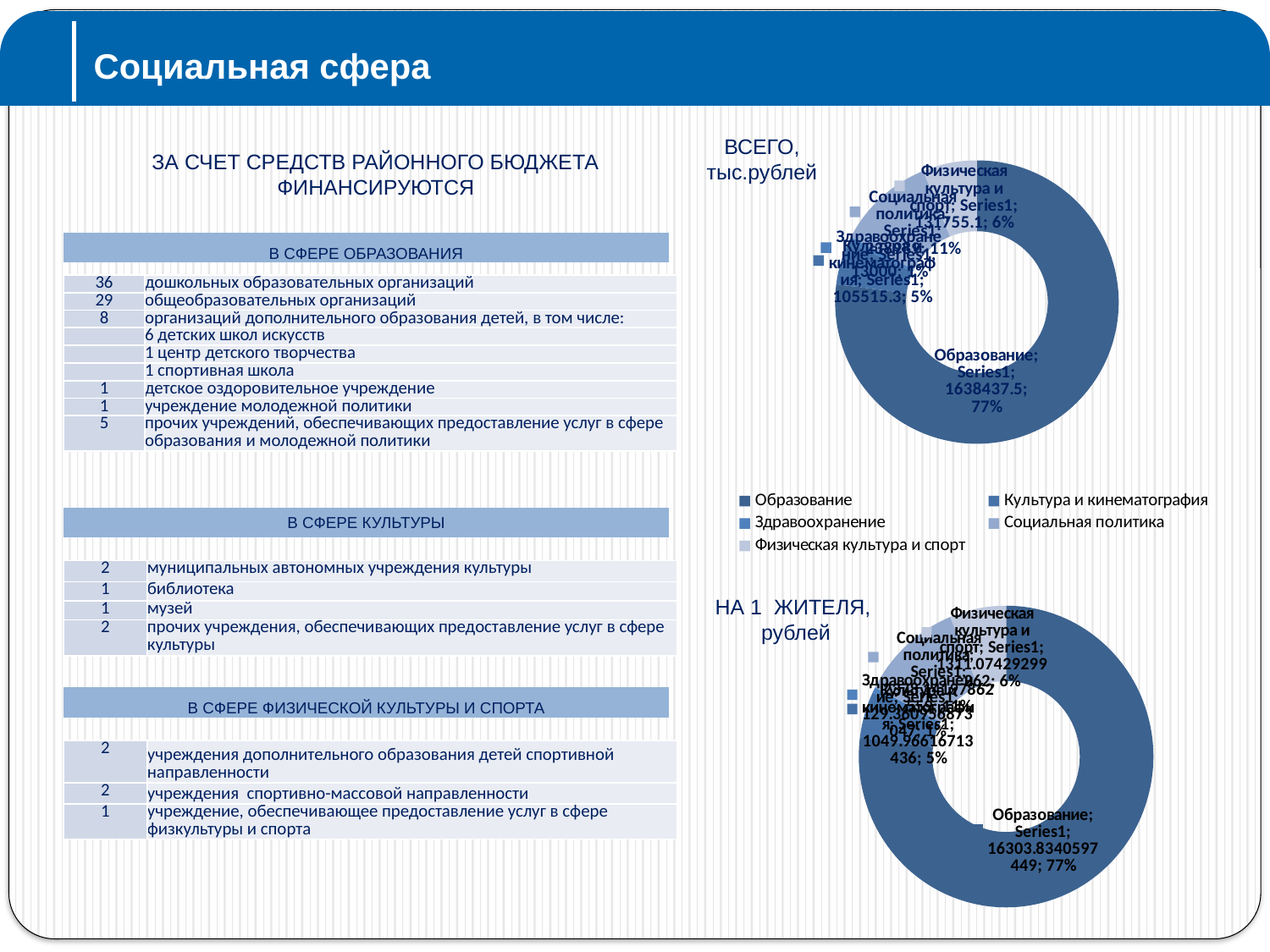
In the "ВСЕГО, тыс.рублей" chart, what is the value for Образование? 1638437.5 In the "НА 1 ЖИТЕЛЯ, рублей" chart, what share does Культура и кинематография have? 5% Which category is shown in the darkest blue in the legend of the "ВСЕГО, тыс.рублей" chart? Образование In the "ВСЕГО, тыс.рублей" chart, what is the value for Культура и кинематография? 105515.3 What kind of chart is the "ВСЕГО, тыс.рублей" chart? doughnut (pie) chart In the "ВСЕГО, тыс.рублей" chart, which is larger: Физическая культура и спорт or Культура и кинематография? Физическая культура и спорт In the "НА 1 ЖИТЕЛЯ, рублей" chart, what share does Образование have? 77% In the "ВСЕГО, тыс.рублей" chart, which category has the largest share? Образование In the "НА 1 ЖИТЕЛЯ, рублей" chart, which category has the largest share? Образование In the "ВСЕГО, тыс.рублей" chart, what is the value for Физическая культура и спорт? 131755.1 How many categories does the legend of the "ВСЕГО, тыс.рублей" chart list? 5 In the "ВСЕГО, тыс.рублей" chart, what share does Образование have? 77%